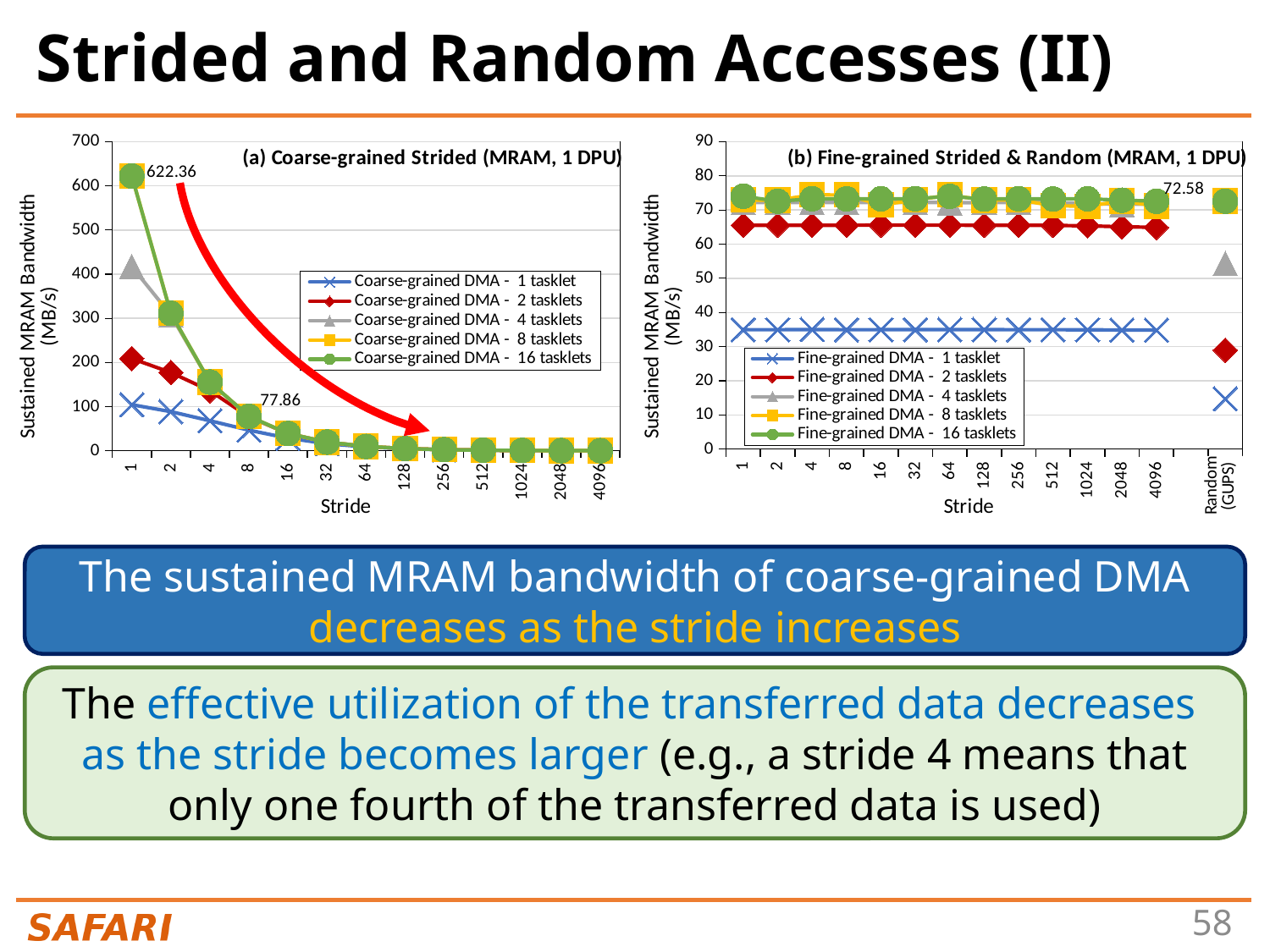
How many categories are on the x axis of chart (b) Fine-grained Strided & Random (MRAM, 1 DPU)? 14 In chart (a) Coarse-grained Strided (MRAM, 1 DPU), do the values for the 16 tasklets series rise or fall as the stride increases? fall In chart (b) Fine-grained Strided & Random (MRAM, 1 DPU), which is larger at stride 1: the 2 tasklets series or the 1 tasklet series? 2 tasklets In chart (b) Fine-grained Strided & Random (MRAM, 1 DPU), is the value for the 4 tasklets series at Random (GUPS) greater or less than 50? greater How many stride values are on the x axis of chart (a) Coarse-grained Strided (MRAM, 1 DPU)? 13 How many series does the legend of chart (a) Coarse-grained Strided (MRAM, 1 DPU) list? 5 In chart (b) Fine-grained Strided & Random (MRAM, 1 DPU), what is the data label shown at stride 4096? 72.58 In chart (a) Coarse-grained Strided (MRAM, 1 DPU), what is the smaller of the two data labels printed on the chart? 77.86 In chart (b) Fine-grained Strided & Random (MRAM, 1 DPU), is the value for the 1 tasklet series at stride 1 greater or less than 40? less What kind of chart is chart (b) Fine-grained Strided & Random (MRAM, 1 DPU)? line chart In chart (a) Coarse-grained Strided (MRAM, 1 DPU), what is the data label shown at stride 1 for the 16 tasklets series? 622.36 What is the label of the y axis of chart (a) Coarse-grained Strided (MRAM, 1 DPU)? Sustained MRAM Bandwidth (MB/s)